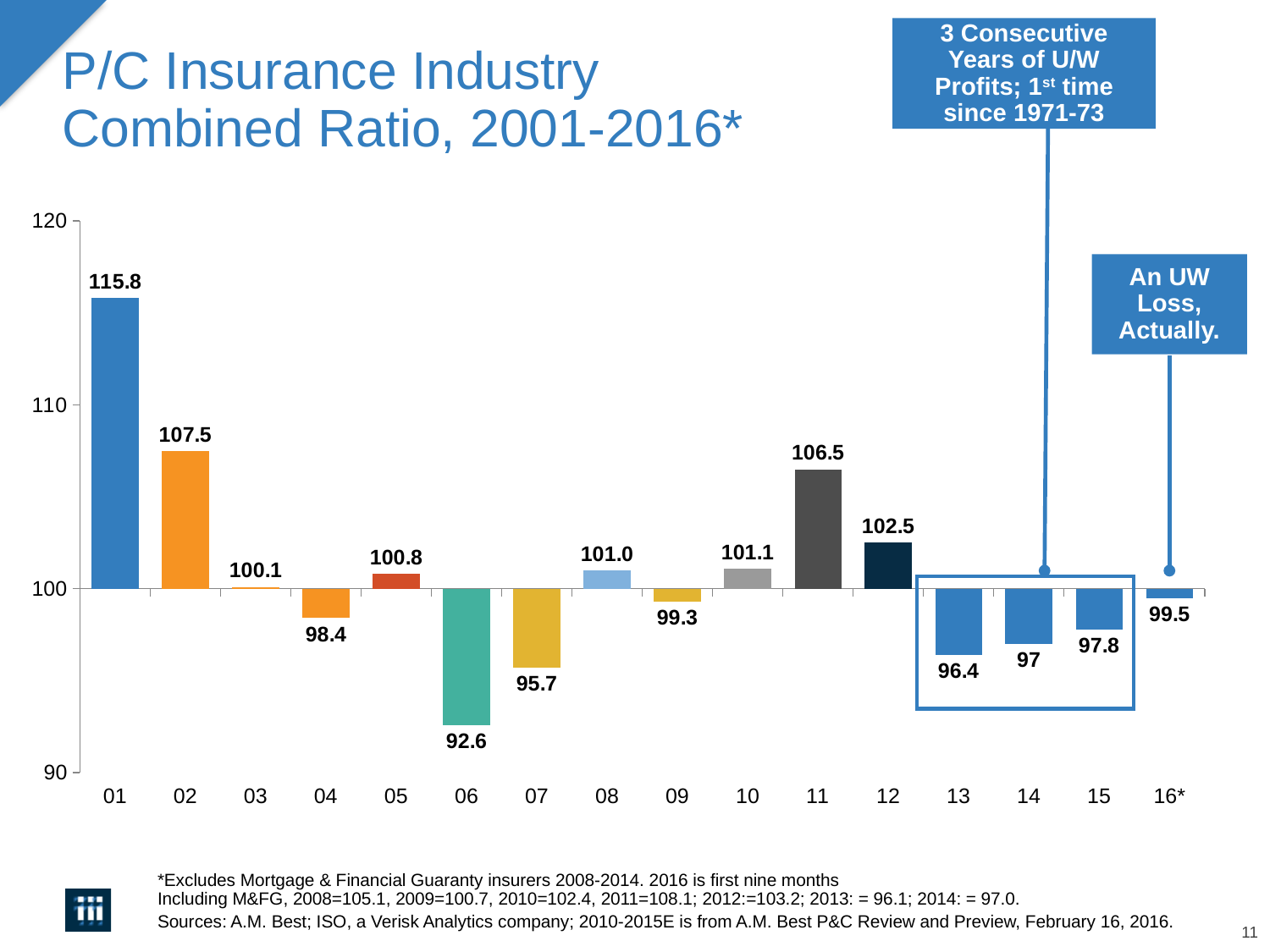
What is the combined ratio for 2006? 92.6 How many years are shown on the x axis? 16 Is the combined ratio for 2007 greater or less than 100? less Do the combined ratios rise or fall from 2013 to 2015? rise Which year has the lowest combined ratio? 06 Which year has the highest combined ratio? 01 What is the combined ratio for 2016*? 99.5 What is the difference between the combined ratio for 2011 and 2012? 4.0 What is the combined ratio for 2001? 115.8 What kind of chart is shown on the slide? bar chart Which year has a higher combined ratio, 2002 or 2011? 02 What is the title of the chart? P/C Insurance Industry Combined Ratio, 2001-2016*